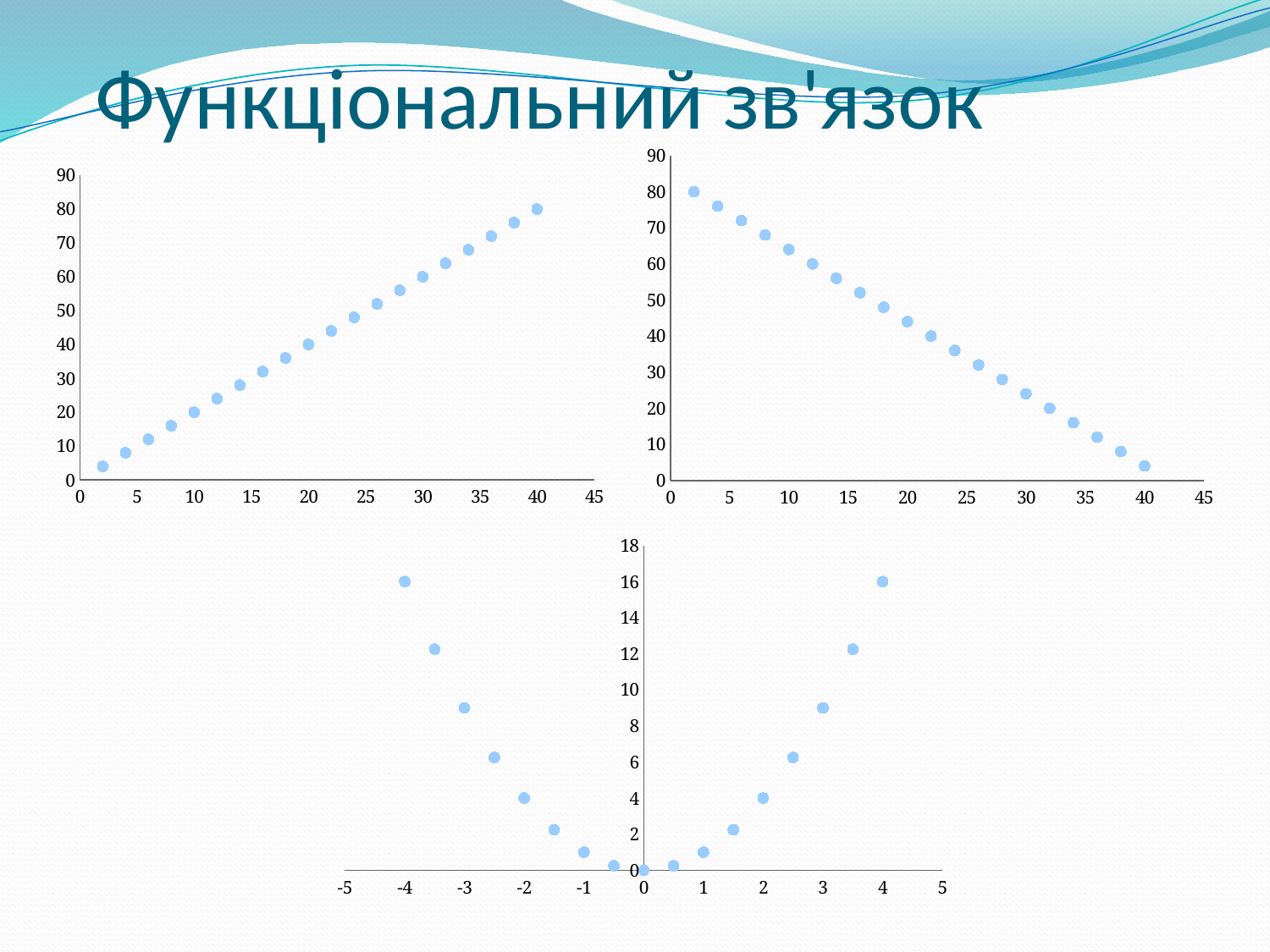
What kind of chart is the top-left chart? scatter chart In the bottom chart, is the value at x = 3 greater or less than 8? greater In the top-right chart, do the values rise or fall as x increases? fall In the top-left chart, what is the y value of the point at x = 40? 80 In the top-right chart, is the value at x = 30 greater or less than 30? less In the top-right chart, what is the y value of the point at x = 2? 80 In the top-left chart, is the value at x = 30 greater or less than 50? greater In the top-left chart, do the values rise or fall as x increases? rise In the bottom chart, at which x value is the lowest point? 0 What is the title of the slide? Функціональний зв'язок In the bottom chart, what is the y value of the point at x = 4? 16 In the top-left chart, what is the y value of the point at x = 20? 40